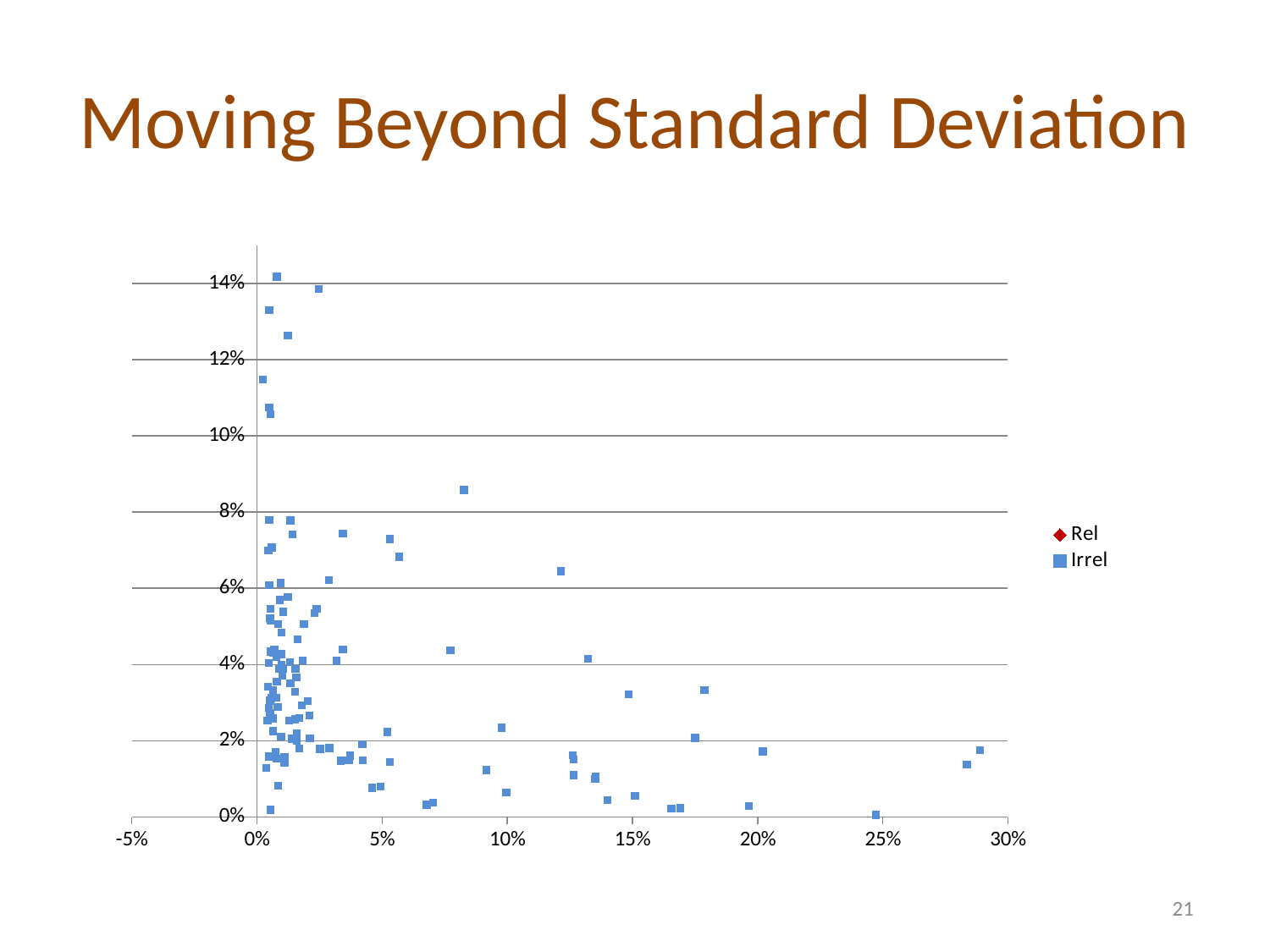
Is the x-axis value of the rightmost plotted point greater or less than 25%? greater What are the two series names listed in the legend? Rel and Irrel How many series does the legend list? 2 What is the title of the slide containing the chart? Moving Beyond Standard Deviation Is the y-axis value of the point plotted near 20% on the x axis with the higher y value greater or less than 4%? less What kind of chart is shown on the slide? scatter chart Is the y-axis value of the highest plotted point greater or less than 12%? greater